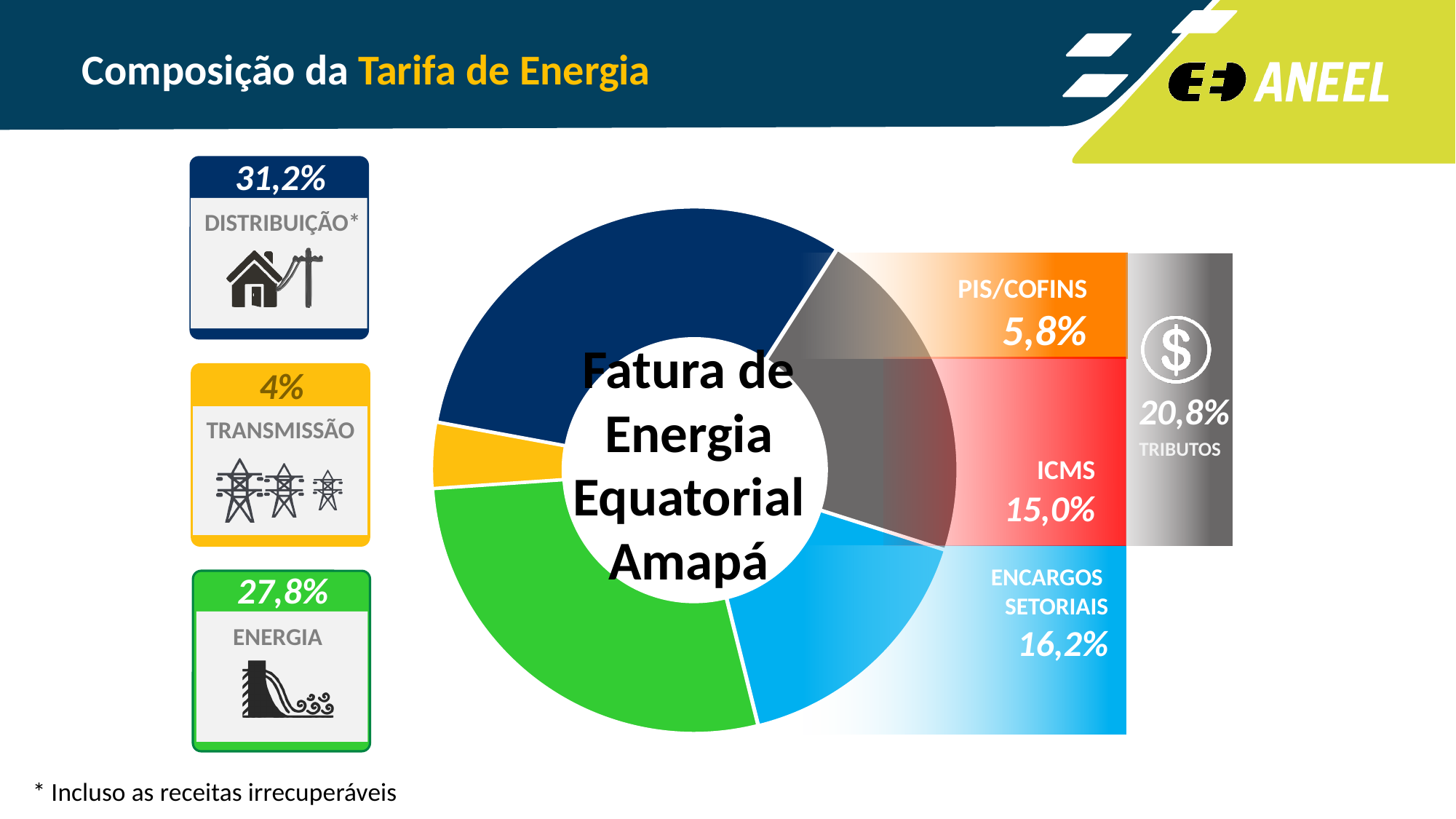
What is the share of ICMS within the tributos? 15,0% What is the share of PIS/COFINS within the tributos? 5,8% Which component has the smallest share of the energy bill? Transmissão Which is larger, the share of Encargos Setoriais or the share of Tributos? Tributos What kind of chart is shown on the slide? Donut (pie) chart Which component has the largest share of the energy bill? Distribuição What share of the energy bill does Energia account for? 27,8% What share of the energy bill do Tributos account for in total? 20,8% What share of the energy bill does Distribuição account for? 31,2% What share of the energy bill does Transmissão account for? 4% What share of the energy bill do Encargos Setoriais account for? 16,2% What is the difference in percentage points between the Distribuição and Energia shares? 3,4